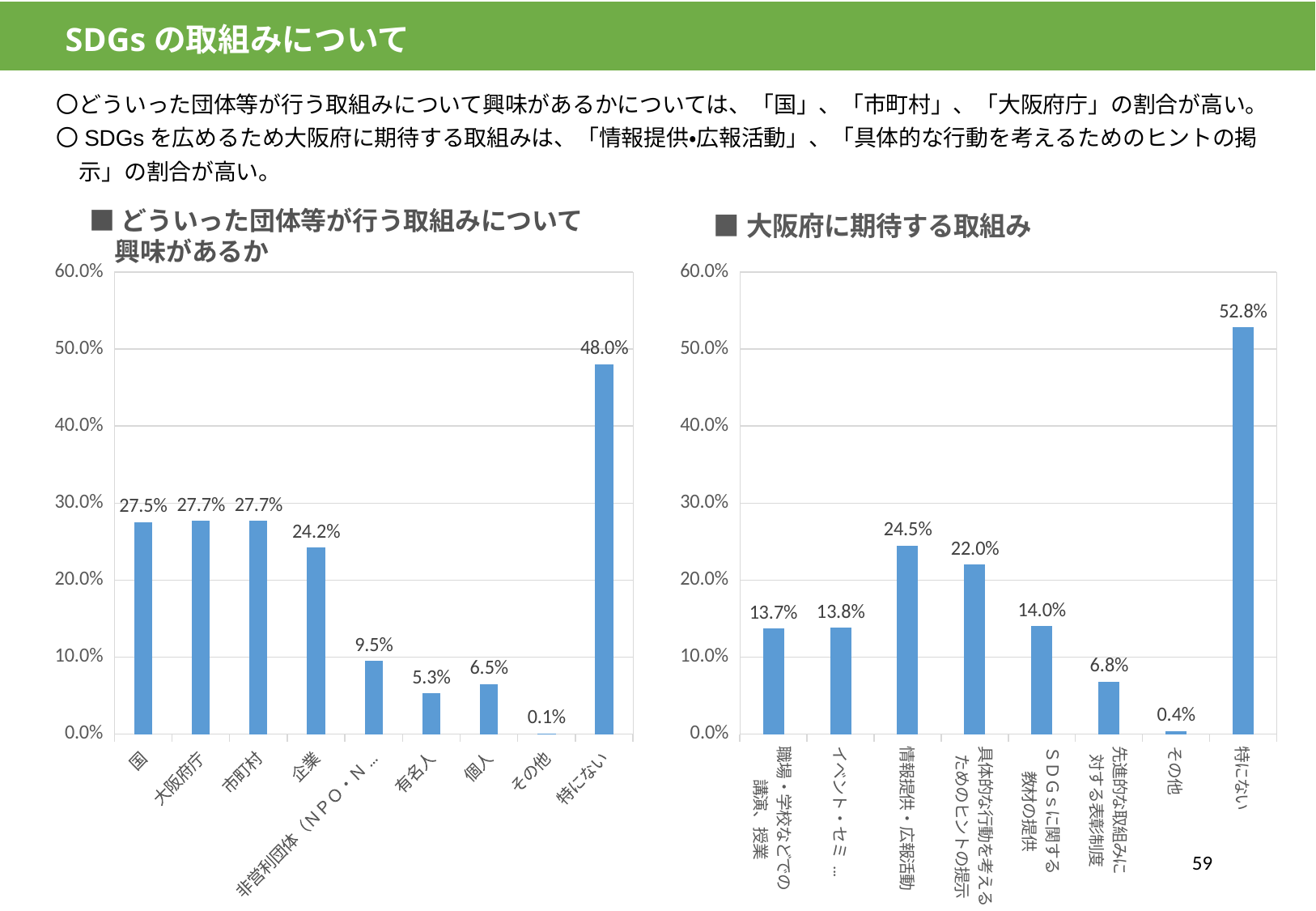
In the left chart (どういった団体等が行う取組みについて興味があるか), which category has the lowest value? その他 In the right chart (大阪府に期待する取組み), how many categories are shown? 8 In the right chart (大阪府に期待する取組み), what is the value for 情報提供・広報活動? 24.5% In the left chart (どういった団体等が行う取組みについて興味があるか), which is larger, 個人 or 有名人? 個人 In the right chart (大阪府に期待する取組み), what is the difference between 情報提供・広報活動 and 具体的な行動を考えるためのヒントの提示? 2.5% In the left chart (どういった団体等が行う取組みについて興味があるか), what is the value for 国? 27.5% In the left chart (どういった団体等が行う取組みについて興味があるか), what is the difference between 企業 and 有名人? 18.9% In the right chart (大阪府に期待する取組み), which category has the lowest value? その他 In the left chart (どういった団体等が行う取組みについて興味があるか), how many categories are shown? 9 What type of chart is the right chart (大阪府に期待する取組み)? Bar chart In the left chart (どういった団体等が行う取組みについて興味があるか), which category has the highest value? 特にない In the right chart (大阪府に期待する取組み), what is the value for 特にない? 52.8%